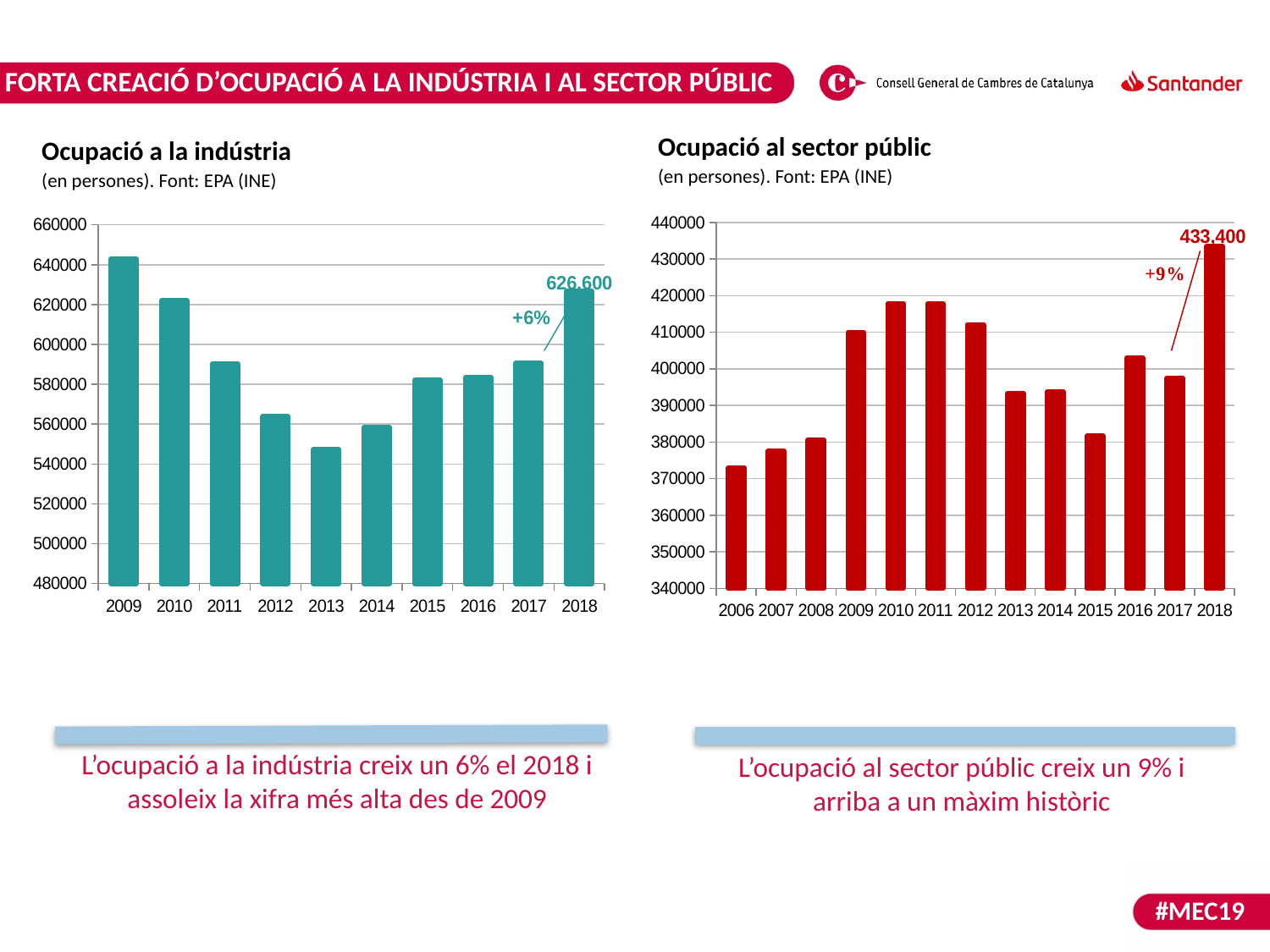
In the 'Ocupació a la indústria' chart, which year has the lowest value? 2013 In the 'Ocupació al sector públic' chart, what value is labelled for 2018? 433.400 What type of chart is the 'Ocupació al sector públic' chart? Bar chart In the 'Ocupació al sector públic' chart, is the value for 2010 greater or less than 410000? greater In the 'Ocupació a la indústria' chart, is the value for 2013 greater or less than 560000? less In the 'Ocupació a la indústria' chart, which year has the highest value? 2009 In the 'Ocupació al sector públic' chart, which year has the highest value? 2018 How many years are shown on the x axis of the 'Ocupació al sector públic' chart? 13 In the 'Ocupació al sector públic' chart, which year has the lowest value? 2006 In the 'Ocupació a la indústria' chart, what value is labelled for 2018? 626.600 How many years are shown on the x axis of the 'Ocupació a la indústria' chart? 10 In the 'Ocupació al sector públic' chart, which is larger, the value for 2008 or the value for 2009? 2009